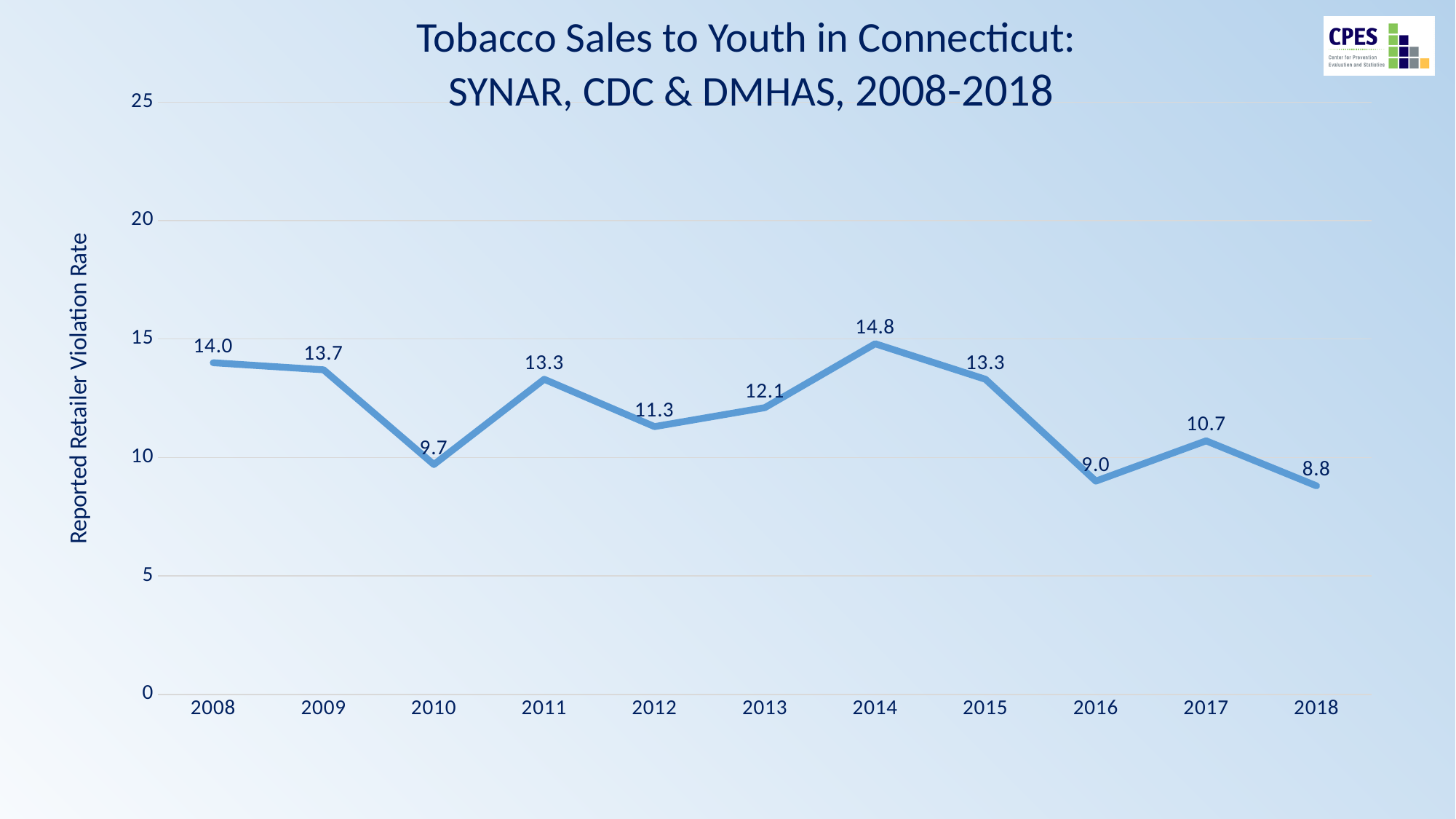
What is the reported retailer violation rate for 2014? 14.8 How many years are plotted on the chart? 11 Which year has the highest reported retailer violation rate? 2014 Which year has a higher violation rate, 2012 or 2013? 2013 What is the difference between the violation rate in 2008 and in 2018? 5.2 What is the label on the vertical axis? Reported Retailer Violation Rate What is the difference between the violation rate in 2014 and in 2016? 5.8 Is the value for 2017 greater or less than 10? greater What kind of chart is shown on the slide? Line chart What is the reported retailer violation rate for 2018? 8.8 Which year has the lowest reported retailer violation rate? 2018 What is the reported retailer violation rate for 2010? 9.7